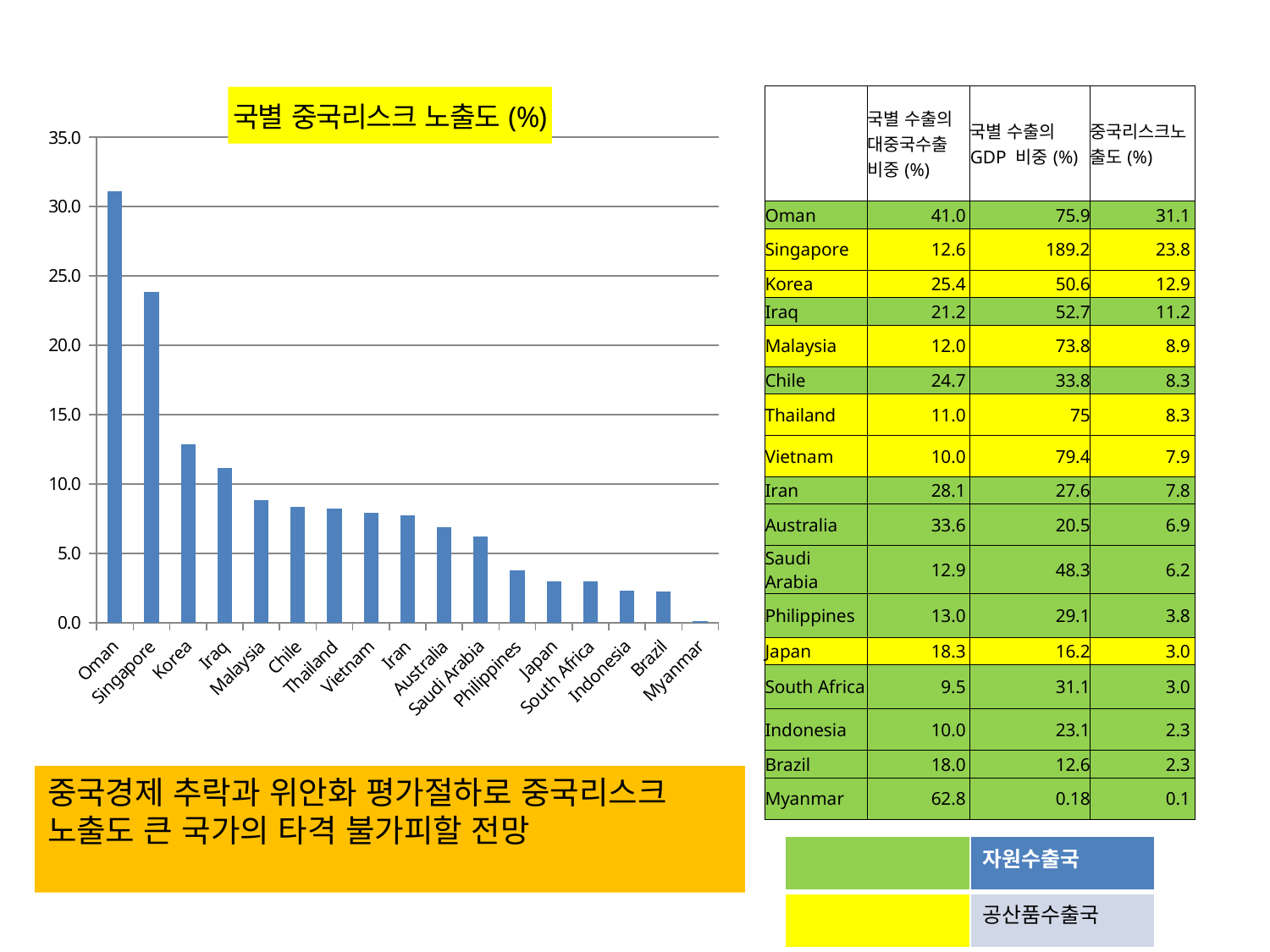
What kind of chart is shown on the slide? bar chart How many countries are plotted on the x axis of the chart? 17 What is the difference between the 중국리스크노출도 (%) values of Oman and Singapore? 7.3 Is the value for Iraq in the chart greater or less than 15.0? less Which has a larger value in the chart, Korea or Iraq? Korea Is the value for Korea in the chart greater or less than 10.0? greater What is the title of the chart? 국별 중국리스크 노출도 (%) What is the 중국리스크노출도 (%) value for Oman? 31.1 Which country has the highest value in the chart? Oman Which country has the lowest value in the chart? Myanmar Do the values in the chart rise or fall from left to right along the x axis? fall What is the 중국리스크노출도 (%) value for Singapore? 23.8